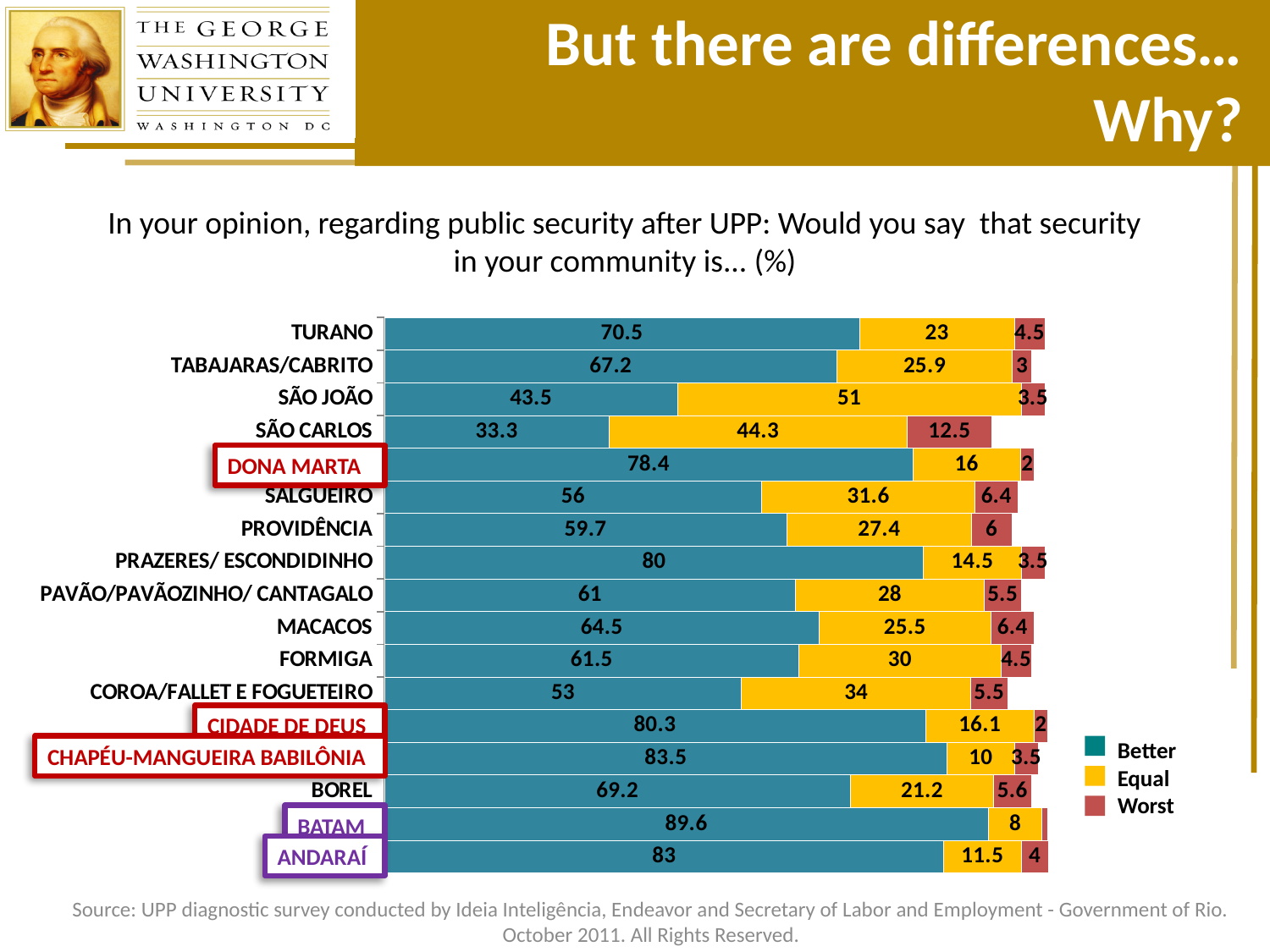
How many series does the legend list? 3 What kind of chart is shown on the slide? Stacked bar chart What is the Better value for CHAPÉU-MANGUEIRA BABILÔNIA? 83.5 Which has a larger Equal value, SÃO JOÃO or SÃO CARLOS? SÃO JOÃO What is the Equal value for SÃO JOÃO? 51 Which community has the highest Better value? BATAM What is the difference between the Better values for TURANO and BOREL? 1.3 How many communities are shown in the chart? 17 Which community has the highest Worst value? SÃO CARLOS What percentage of respondents in TURANO said security is Better? 70.5 What is the Worst value for SÃO CARLOS? 12.5 Which community has the lowest Better value? SÃO CARLOS